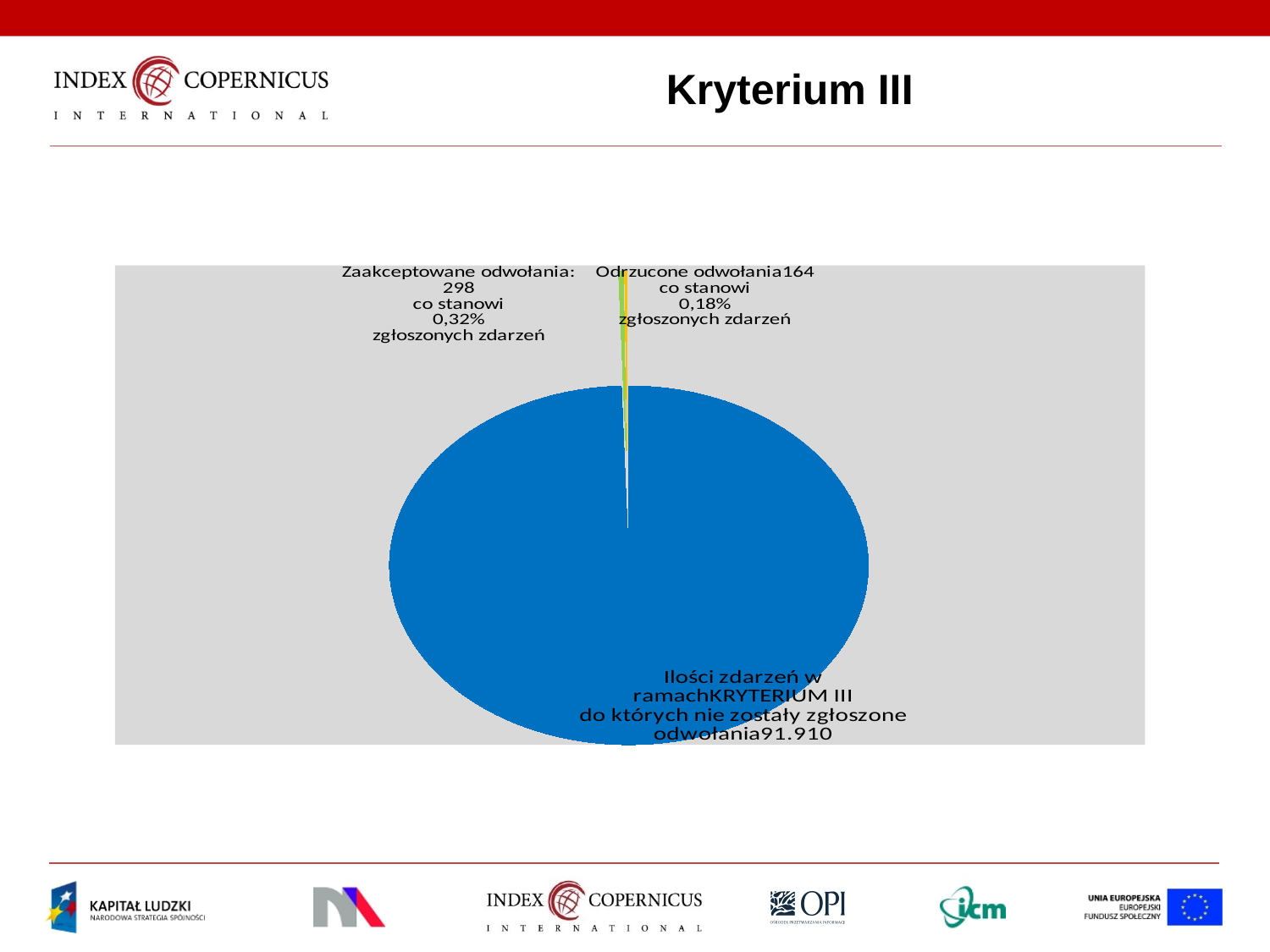
Which slice of the pie chart is the largest? Ilości zdarzeń w ramach KRYTERIUM III do których nie zostały zgłoszone odwołania How many accepted appeals (Zaakceptowane odwołania) are shown on the pie chart? 298 What kind of chart is shown on the slide? pie chart What is the difference between the number of accepted appeals (298) and rejected appeals (164)? 134 How many slices does the pie chart have? 3 How many rejected appeals (Odrzucone odwołania) are shown on the pie chart? 164 What is the title of the slide containing the pie chart? Kryterium III What percentage of reported events do the rejected appeals (Odrzucone odwołania) represent? 0,18% Which slice of the pie chart is the smallest? Odrzucone odwołania What percentage of reported events do the accepted appeals (Zaakceptowane odwołania) represent? 0,32% What is the number of events in Kryterium III for which no appeals were filed, according to the pie chart? 91.910 Which is larger: the number of accepted appeals (Zaakceptowane odwołania) or the number of rejected appeals (Odrzucone odwołania)? Zaakceptowane odwołania